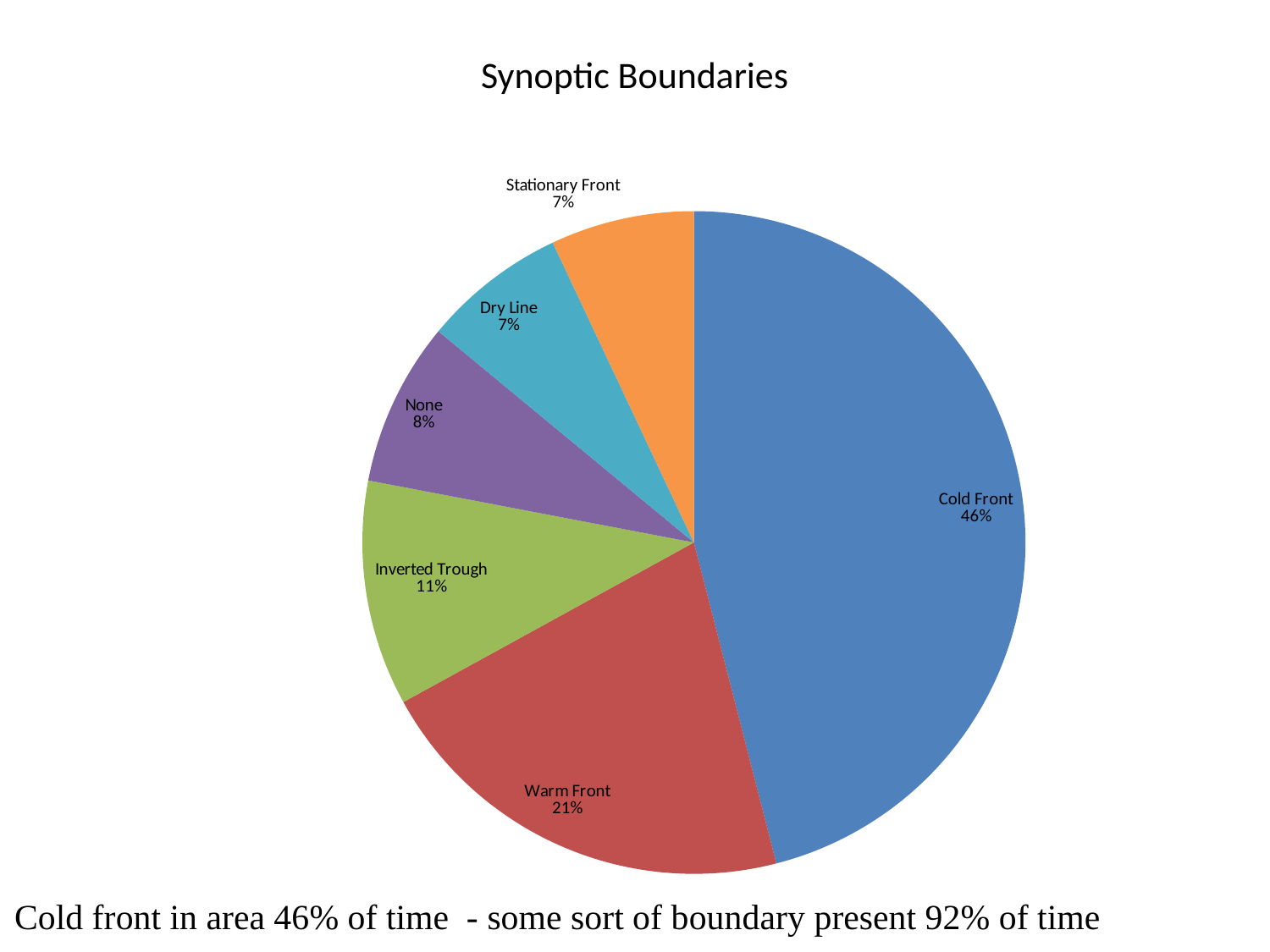
What is the difference between the Inverted Trough and None percentages? 3% What is the title of the chart? Synoptic Boundaries What share of the pie does Cold Front represent? 46% How many categories are shown in the pie chart? 6 What colour is the Cold Front slice? Blue Which category has the smallest slice, Inverted Trough or None? None What is the value shown for Inverted Trough? 11% What is the difference between the Cold Front and Warm Front percentages? 25% What kind of chart is shown on the slide? Pie chart What is the value shown for None? 8% What share of the pie does Warm Front represent? 21% Which category has the largest slice of the pie? Cold Front